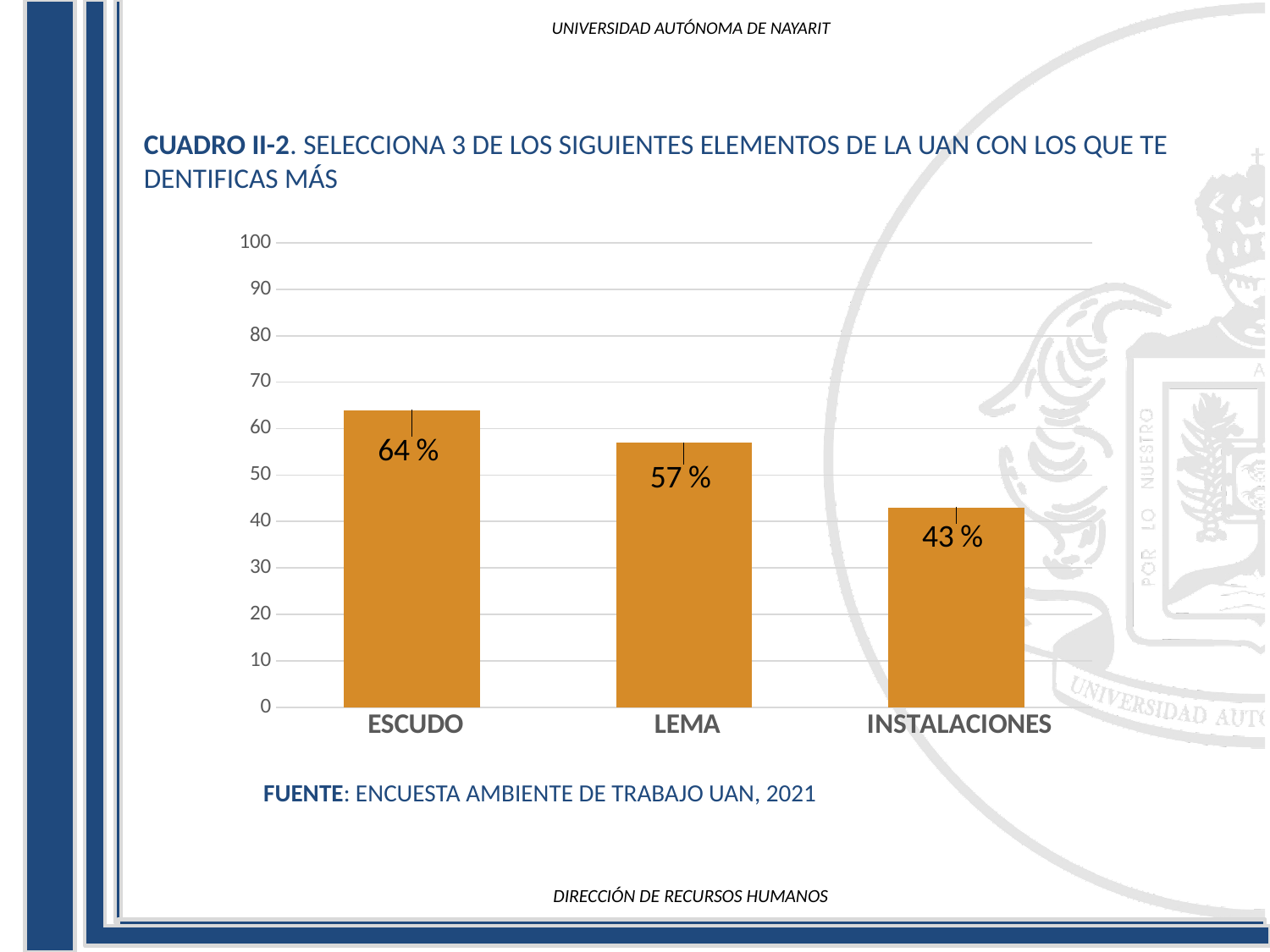
What kind of chart is shown on the slide? bar chart Which is larger, the value for LEMA or the value for INSTALACIONES? LEMA What is the difference between the values for ESCUDO and INSTALACIONES? 21 % What is the value for INSTALACIONES? 43 % How many categories are shown on the x axis? 3 What is the value for ESCUDO? 64 % What is the difference between the values for ESCUDO and LEMA? 7 % Is the value for INSTALACIONES greater or less than 50? less Which category has the highest value? ESCUDO Which category has the lowest value? INSTALACIONES What is the value for LEMA? 57 % Do the values rise or fall from ESCUDO to INSTALACIONES along the x axis? fall